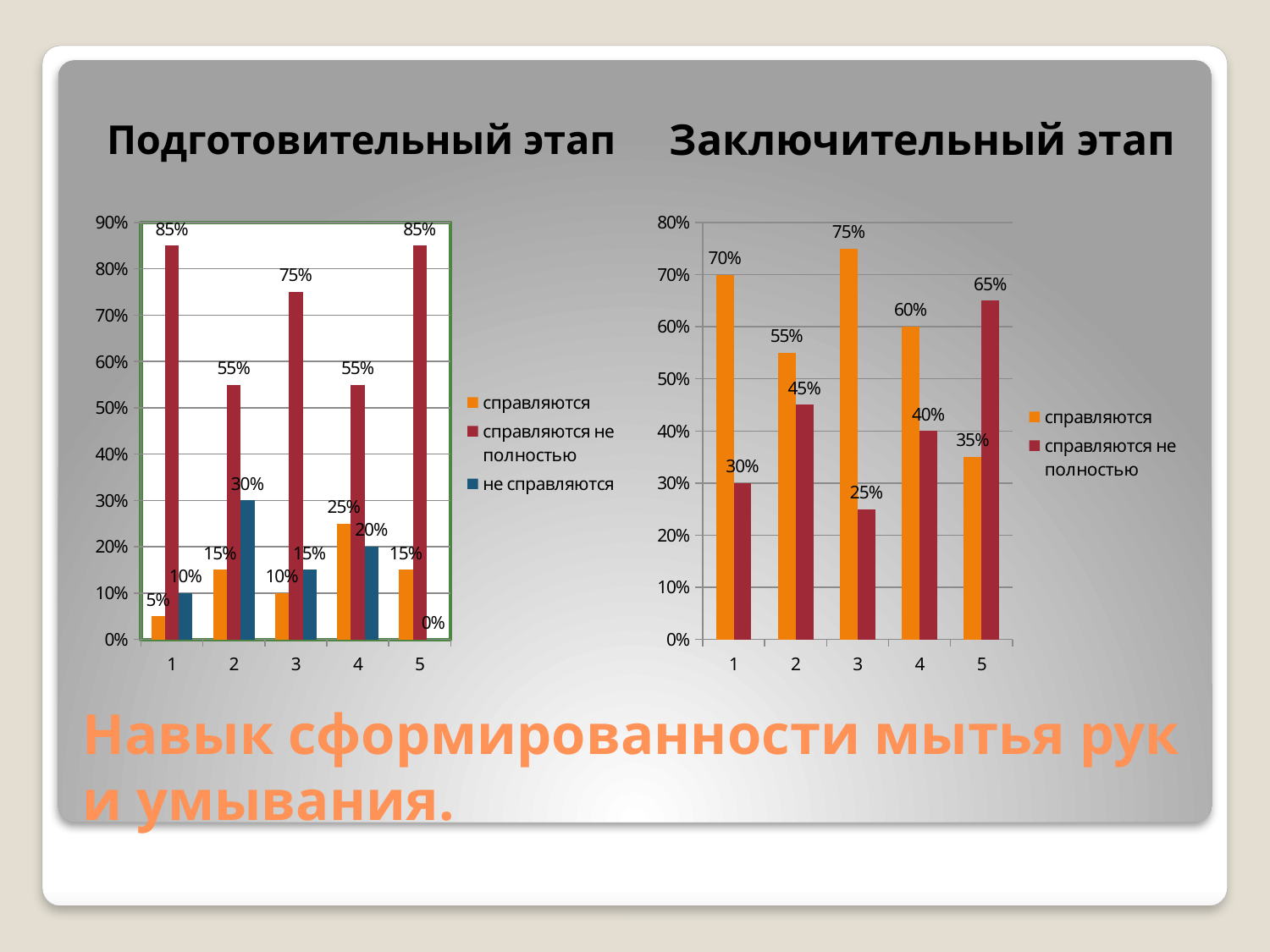
On the 'Заключительный этап' chart, what is the difference between 'справляются' and 'справляются не полностью' at category 1? 40% On the 'Заключительный этап' chart, what is the value for 'справляются' at category 3? 75% On the 'Подготовительный этап' chart, which category has the lowest value for 'не справляются'? 5 On the 'Подготовительный этап' chart, which category has the highest value for 'справляются'? 4 On the 'Заключительный этап' chart, which is larger at category 4: 'справляются' or 'справляются не полностью'? справляются On the 'Заключительный этап' chart, what is the value for 'справляются не полностью' at category 5? 65% On the 'Заключительный этап' chart, which category has the lowest value for 'справляются'? 5 On the 'Подготовительный этап' chart, what is the value for 'справляются не полностью' at category 1? 85% On the 'Подготовительный этап' chart, how many series does the legend list? 3 What type of chart is the 'Заключительный этап' chart? bar chart On the 'Подготовительный этап' chart, what is the value for 'не справляются' at category 2? 30% On the 'Заключительный этап' chart, how many categories are shown on the x axis? 5